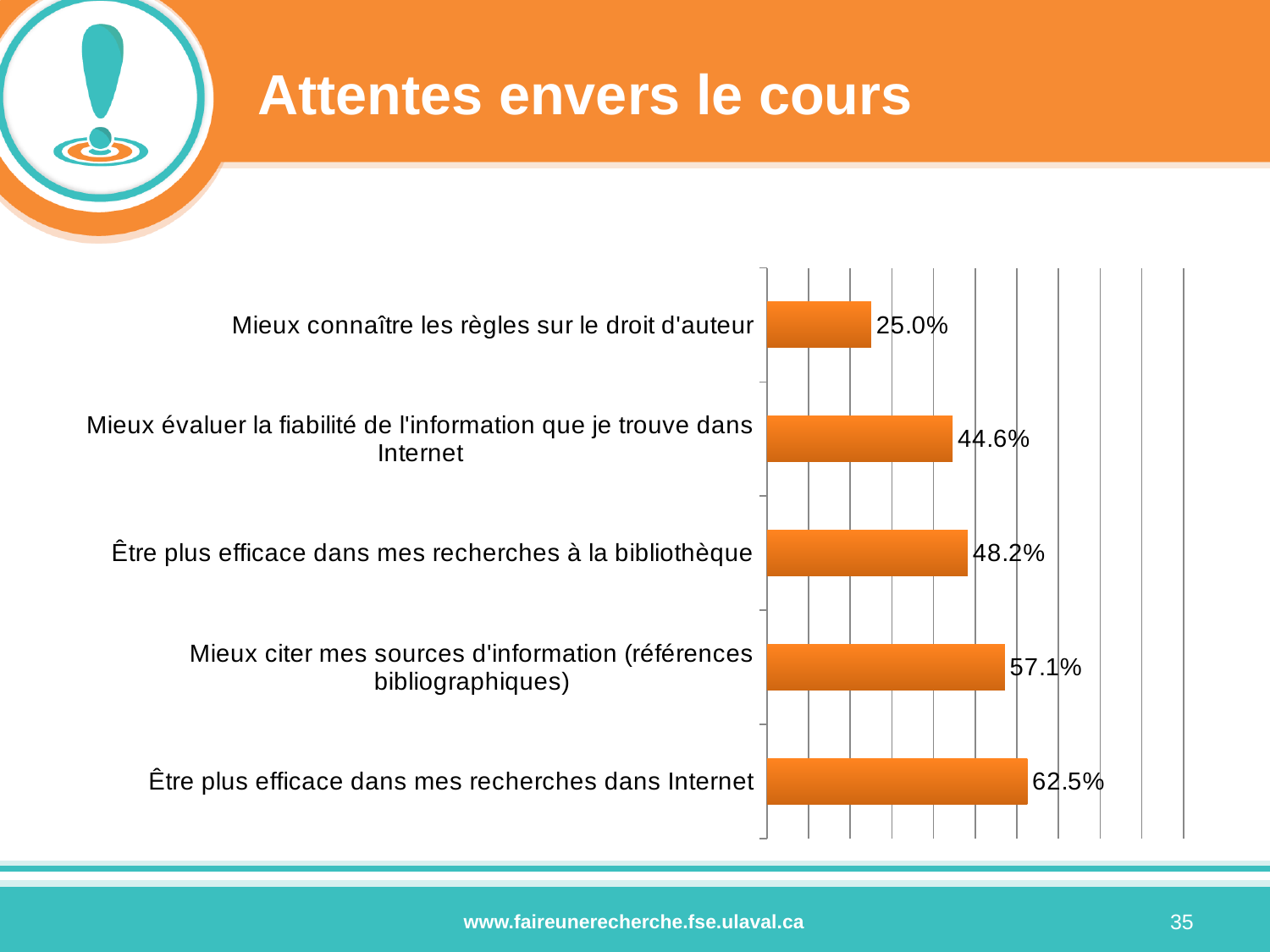
What is the title of the slide containing the chart? Attentes envers le cours What is the value for "Mieux citer mes sources d'information (références bibliographiques)"? 57.1% What is the value for "Être plus efficace dans mes recherches dans Internet"? 62.5% Which category has the lowest value? Mieux connaître les règles sur le droit d'auteur What is the value for "Mieux connaître les règles sur le droit d'auteur"? 25.0% How many categories are plotted in the chart? 5 Which is larger: the value for "Mieux citer mes sources d'information (références bibliographiques)" or the value for "Être plus efficace dans mes recherches à la bibliothèque"? Mieux citer mes sources d'information (références bibliographiques) What is the value for "Être plus efficace dans mes recherches à la bibliothèque"? 48.2% What kind of chart is shown on the slide? Bar chart What is the value for "Mieux évaluer la fiabilité de l'information que je trouve dans Internet"? 44.6% Which category has the highest value? Être plus efficace dans mes recherches dans Internet What is the difference between the values for "Être plus efficace dans mes recherches dans Internet" and "Mieux connaître les règles sur le droit d'auteur"? 37.5%